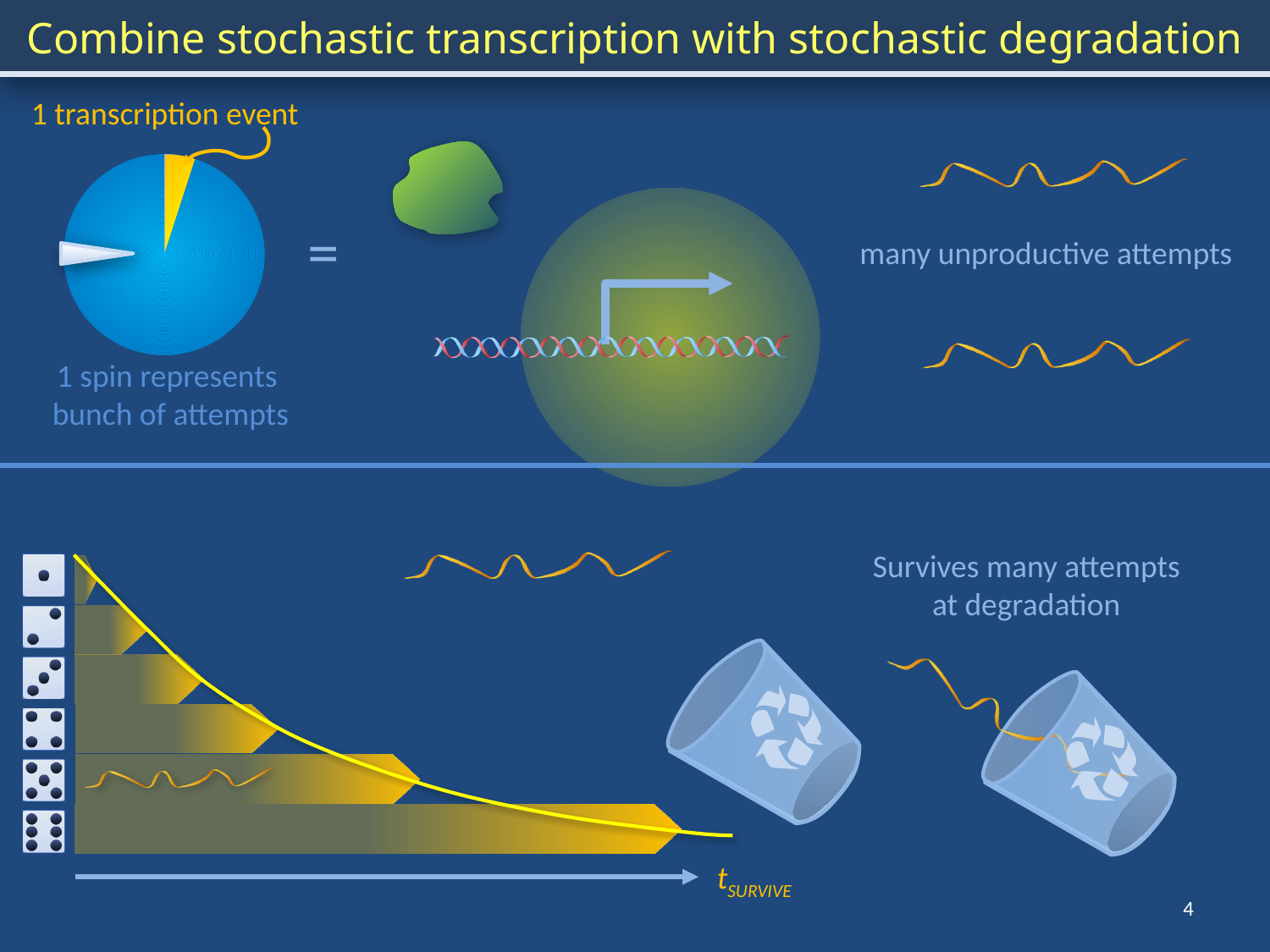
In the bottom-left diagram, which die face has the shortest bar? one dot In the bottom-left diagram, how many horizontal bars are drawn, one per die face? 6 In the top-left pie-style spinner, what does the yellow slice represent? 1 transcription event In the bottom-left diagram, do the bars get longer or shorter going from the one-dot die at the top to the six-dot die at the bottom? longer In the bottom-left diagram, what is the label on the horizontal axis? t_SURVIVE In the bottom-left diagram, which die face has the longest bar? six dots